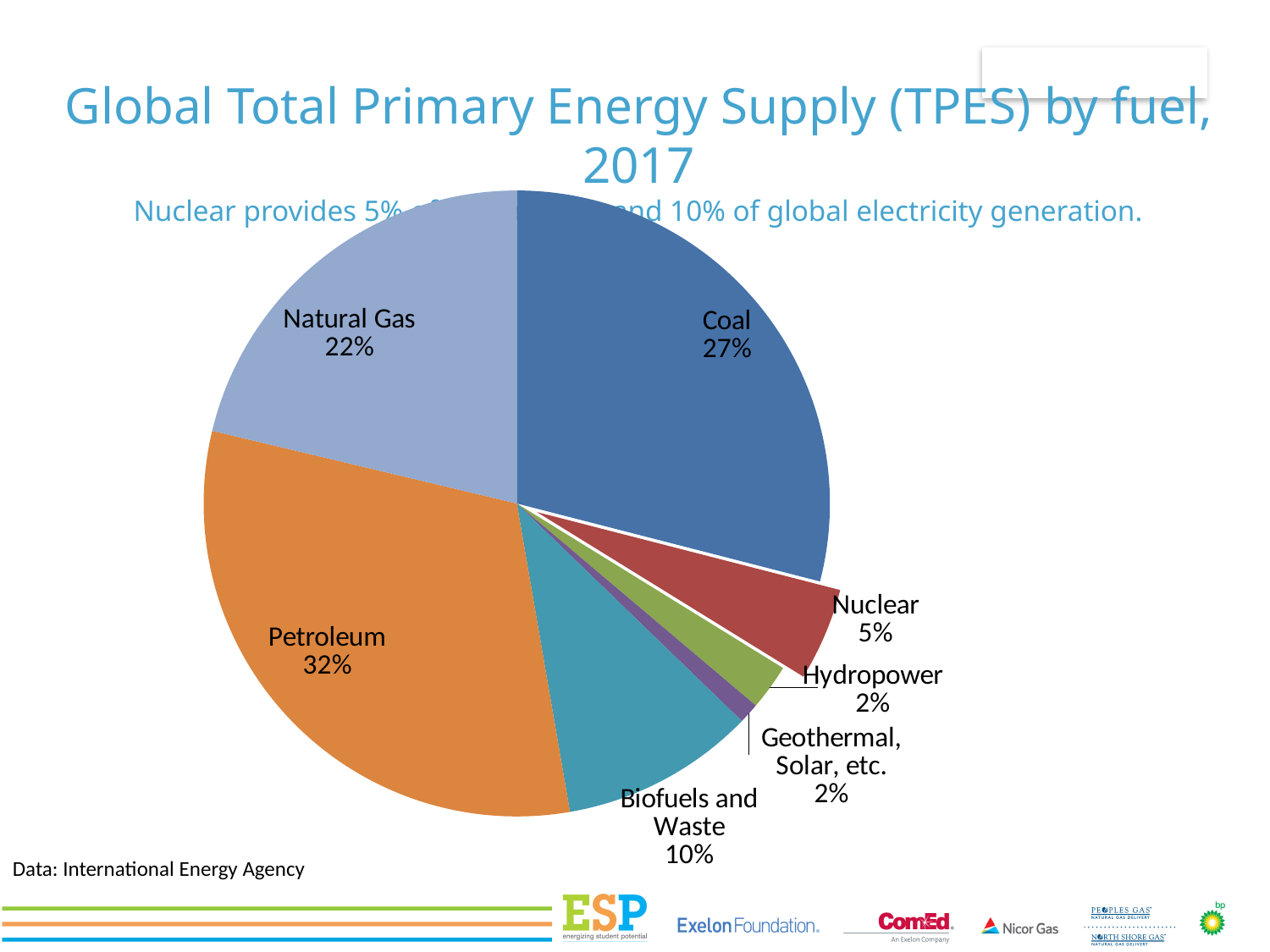
What is the difference in percentage points between Petroleum and Coal? 5 How many slices does the pie chart have? 7 Which is larger, the share for Coal or the share for Natural Gas? Coal What is the title of the chart? Global Total Primary Energy Supply (TPES) by fuel, 2017 What percentage is shown for Natural Gas? 22% Which fuel has the largest slice of the pie? Petroleum What is the combined share of Coal and Petroleum? 59% What share does Nuclear have in the pie chart? 5% What share of global total primary energy supply does Coal provide? 27% What percentage is shown for Biofuels and Waste? 10% What kind of chart is shown on the slide? pie chart What percentage is shown for Hydropower? 2%